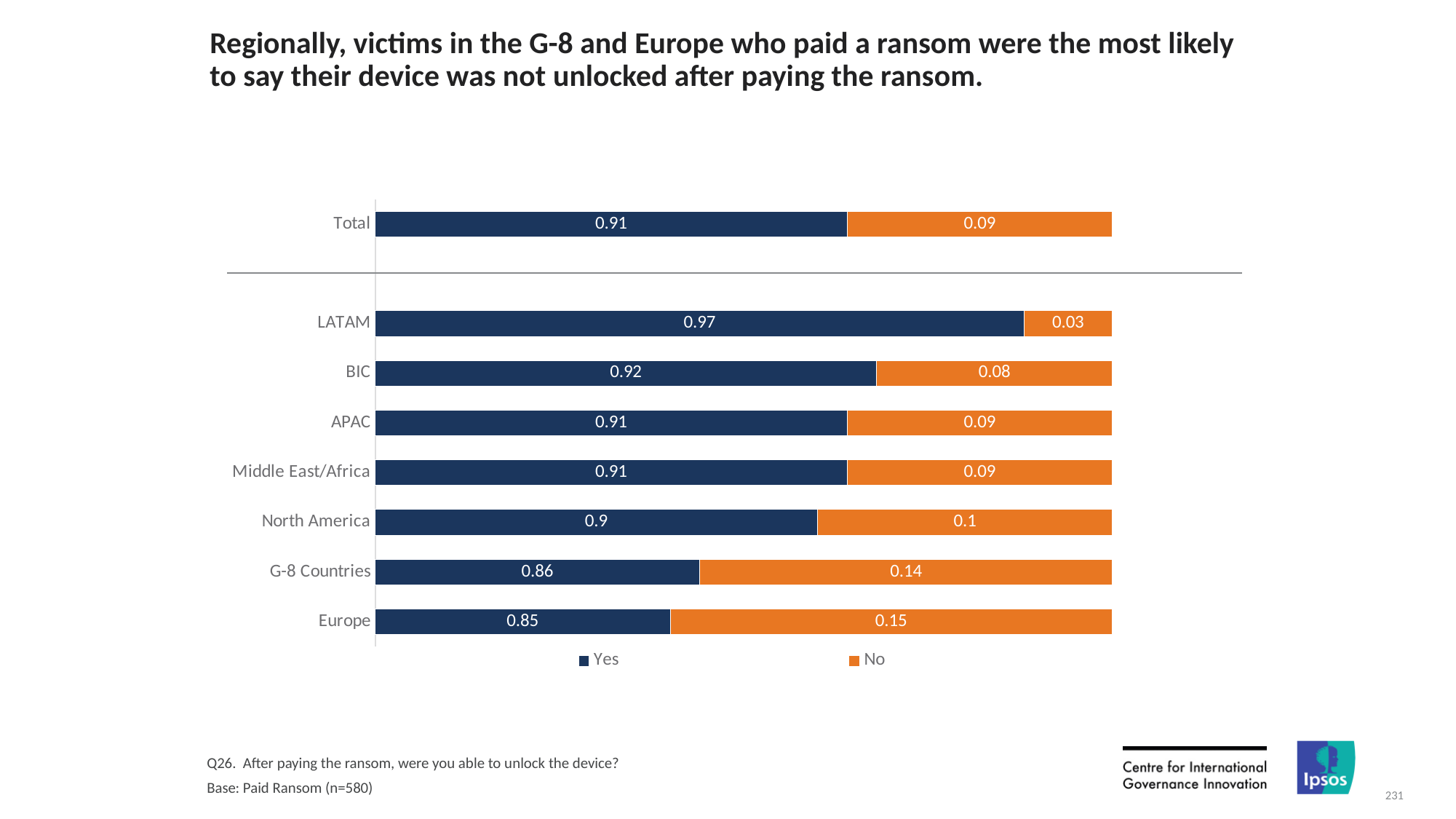
How many series does the legend list? 2 What is the total of the stacked bar for Total? 1 Which region has the highest "Yes" value? LATAM Which is larger, the "Yes" value for BIC or the "Yes" value for G-8 Countries? BIC Which region has the lowest "Yes" value? Europe What is the "Yes" value for LATAM? 0.97 Which colour represents the "No" series? Orange What is the difference between the "No" values for Europe and LATAM? 0.12 What kind of chart is shown on the slide? Stacked bar chart What is the "No" value for G-8 Countries? 0.14 What is the "No" value for Europe? 0.15 What is the "Yes" value for North America? 0.9